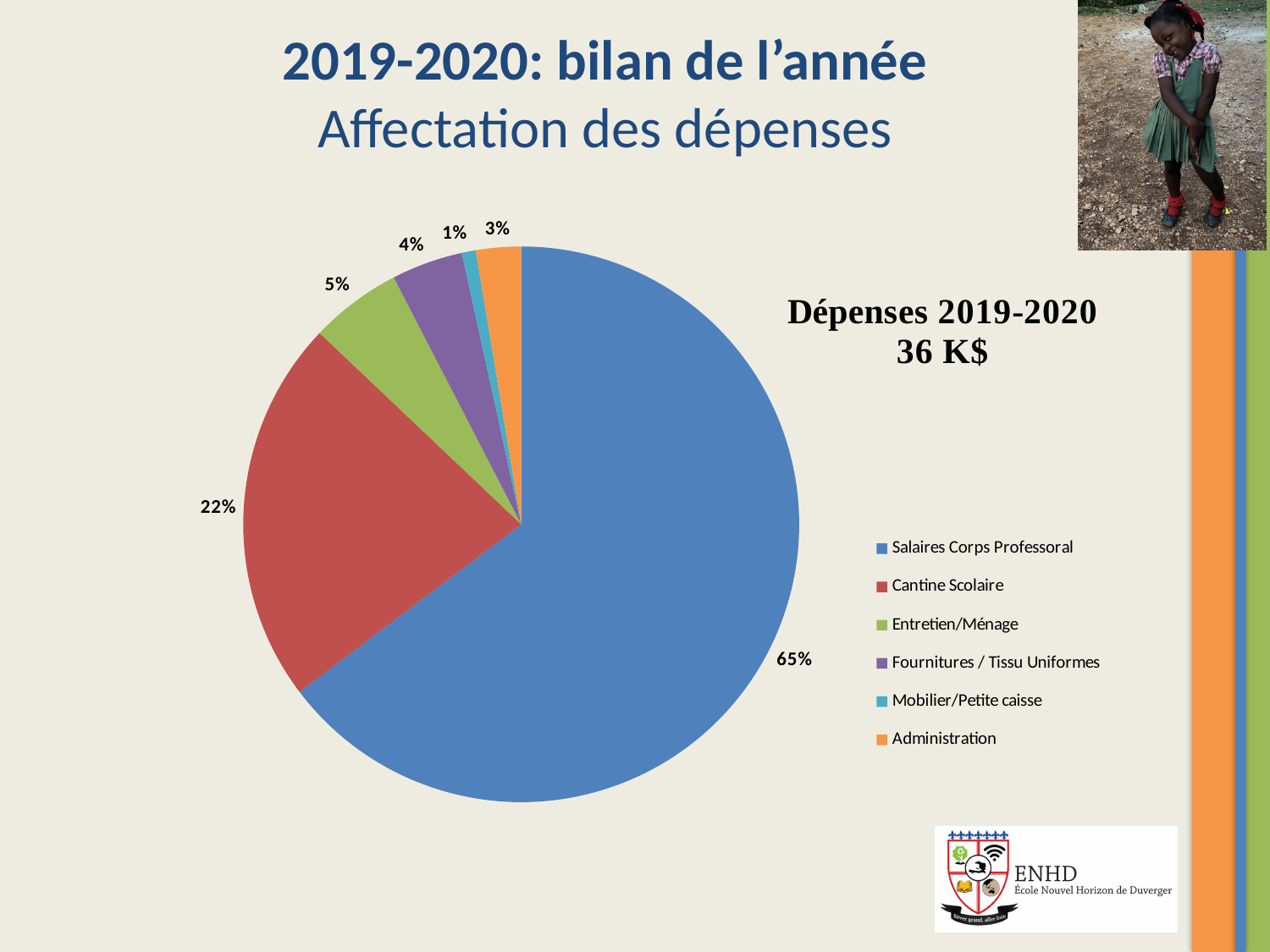
How many categories does the legend list? 6 Which category has the largest slice of the pie? Salaires Corps Professoral What share of the pie does Salaires Corps Professoral represent? 65% What share of the pie does Entretien/Ménage represent? 5% What total expense amount is stated next to the pie chart for 2019-2020? 36 K$ What type of chart is shown on the slide? pie chart What share of the pie does Administration represent? 3% What is the difference in percentage points between Salaires Corps Professoral and Cantine Scolaire? 43 Which is larger, the share for Entretien/Ménage or the share for Administration? Entretien/Ménage Which category has the smallest slice of the pie? Mobilier/Petite caisse